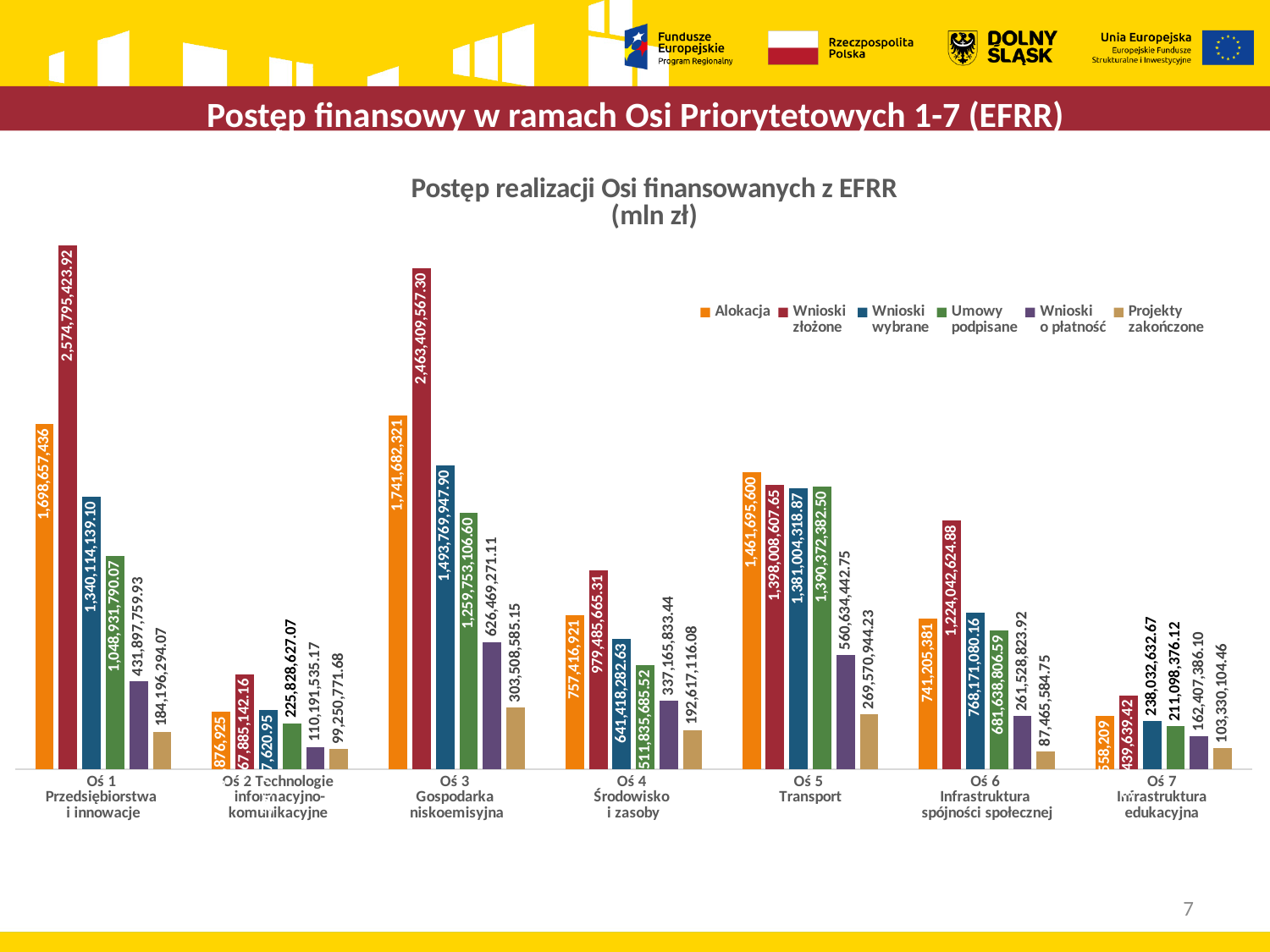
What is the value of Projekty zakończone for Oś 5 Transport? 269,570,944.23 Which category has the highest Wnioski złożone value? Oś 1 Przedsiębiorstwa i innowacje What is the Alokacja value for Oś 6 Infrastruktura spójności społecznej? 741,205,381 What is the difference between Alokacja and Wnioski o płatność for Oś 4 Środowisko i zasoby? 420,251,087.56 Which category has the lowest Projekty zakończone value? Oś 6 Infrastruktura spójności społecznej What is the value of Wnioski złożone for Oś 1 Przedsiębiorstwa i innowacje? 2,574,795,423.92 Which is larger for Oś 5 Transport: Alokacja or Wnioski złożone? Alokacja How many series does the legend list? 6 What kind of chart is shown on the slide? Bar chart How many categories (axes) are shown on the x axis? 7 What is the value of Umowy podpisane for Oś 3 Gospodarka niskoemisyjna? 1,259,753,106.60 What is the title of the chart? Postęp realizacji Osi finansowanych z EFRR (mln zł)